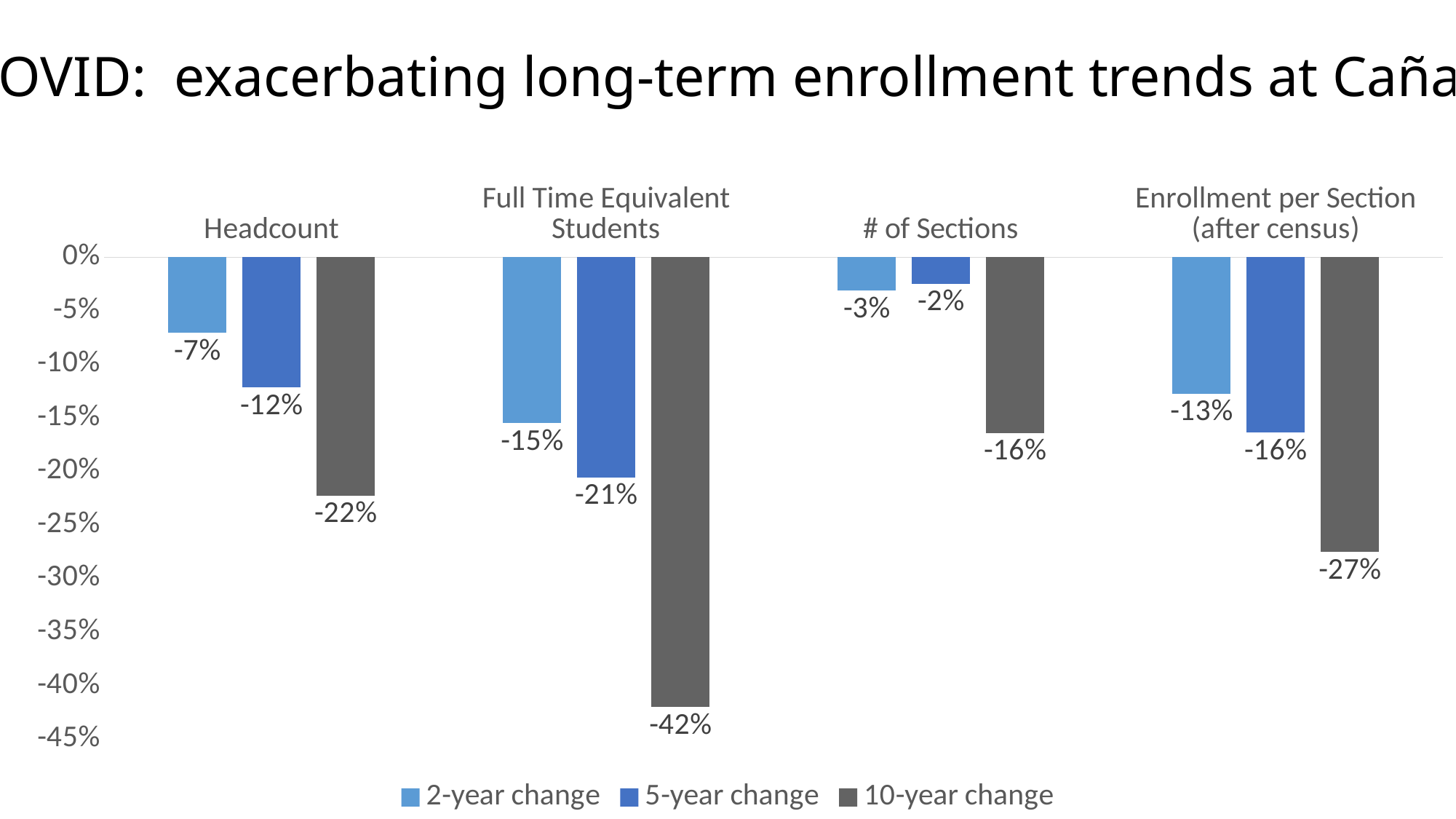
Which category has the smallest 2-year decline? # of Sections What is the difference between the 10-year change and the 2-year change for Headcount? 15 percentage points What is the 5-year change for # of Sections? -2% What is the 10-year change for Full Time Equivalent Students? -42% What is the 10-year change for Enrollment per Section (after census)? -27% What is the 2-year change for Headcount? -7% What kind of chart is shown on the slide? Bar chart How many series does the legend list? 3 How many categories are shown on the x axis? 4 Which series is shown in dark grey in the legend? 10-year change Which is a larger decline: the 5-year change for Headcount or the 5-year change for Enrollment per Section (after census)? Enrollment per Section (after census) Which category has the largest 10-year decline? Full Time Equivalent Students